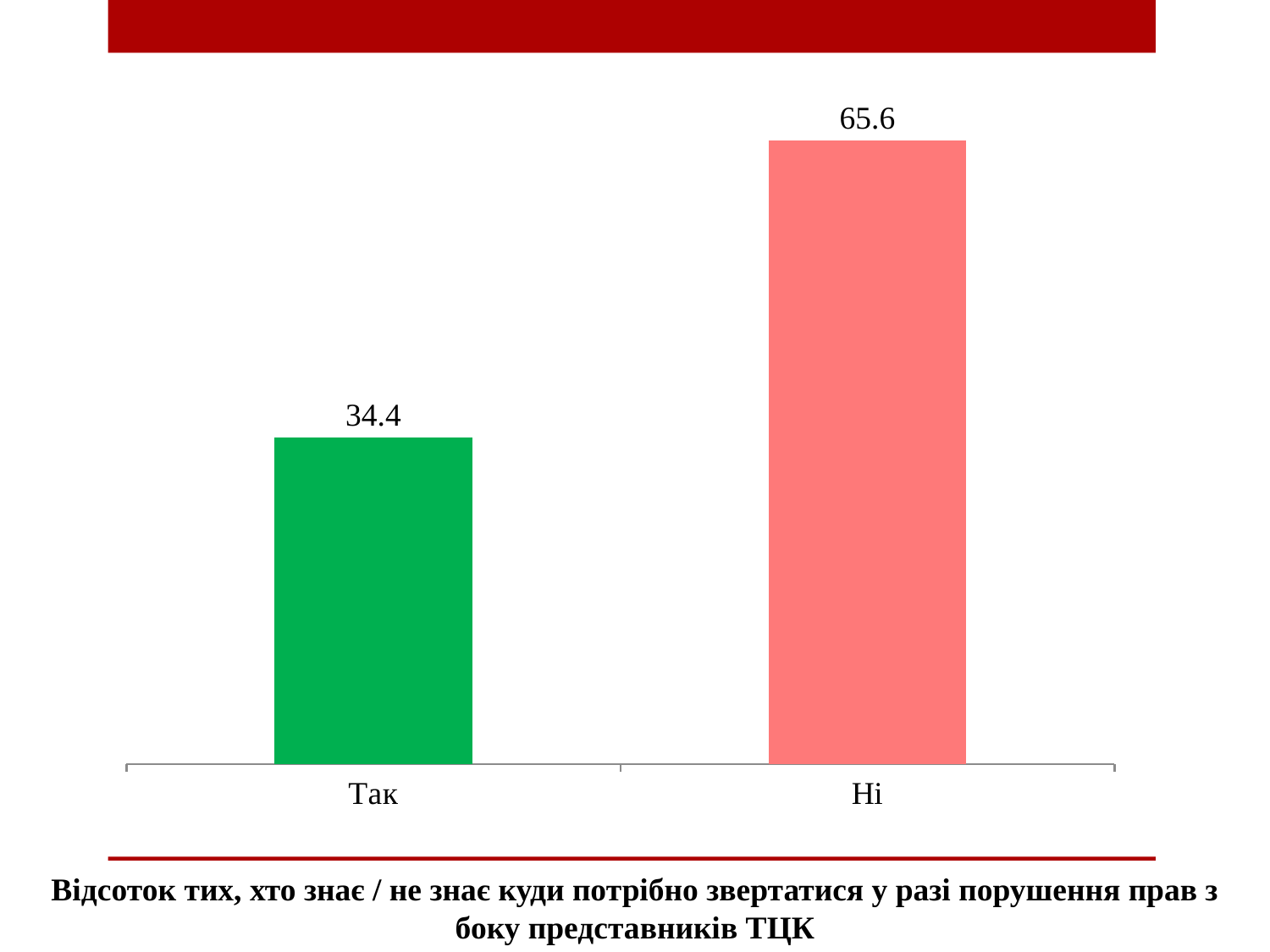
How many categories are shown in the chart? 2 What is the value for "Ні"? 65.6 Which category has the highest value? Ні What colour is the bar for "Ні"? Pink What is the value for "Так"? 34.4 Which category has the lowest value? Так What kind of chart is shown on the slide? Bar chart What colour is the bar for "Так"? Green What is the total of the two values shown in the chart? 100 What is the difference between the values for "Ні" and "Так"? 31.2 Which is larger, the value for "Так" or the value for "Ні"? Ні